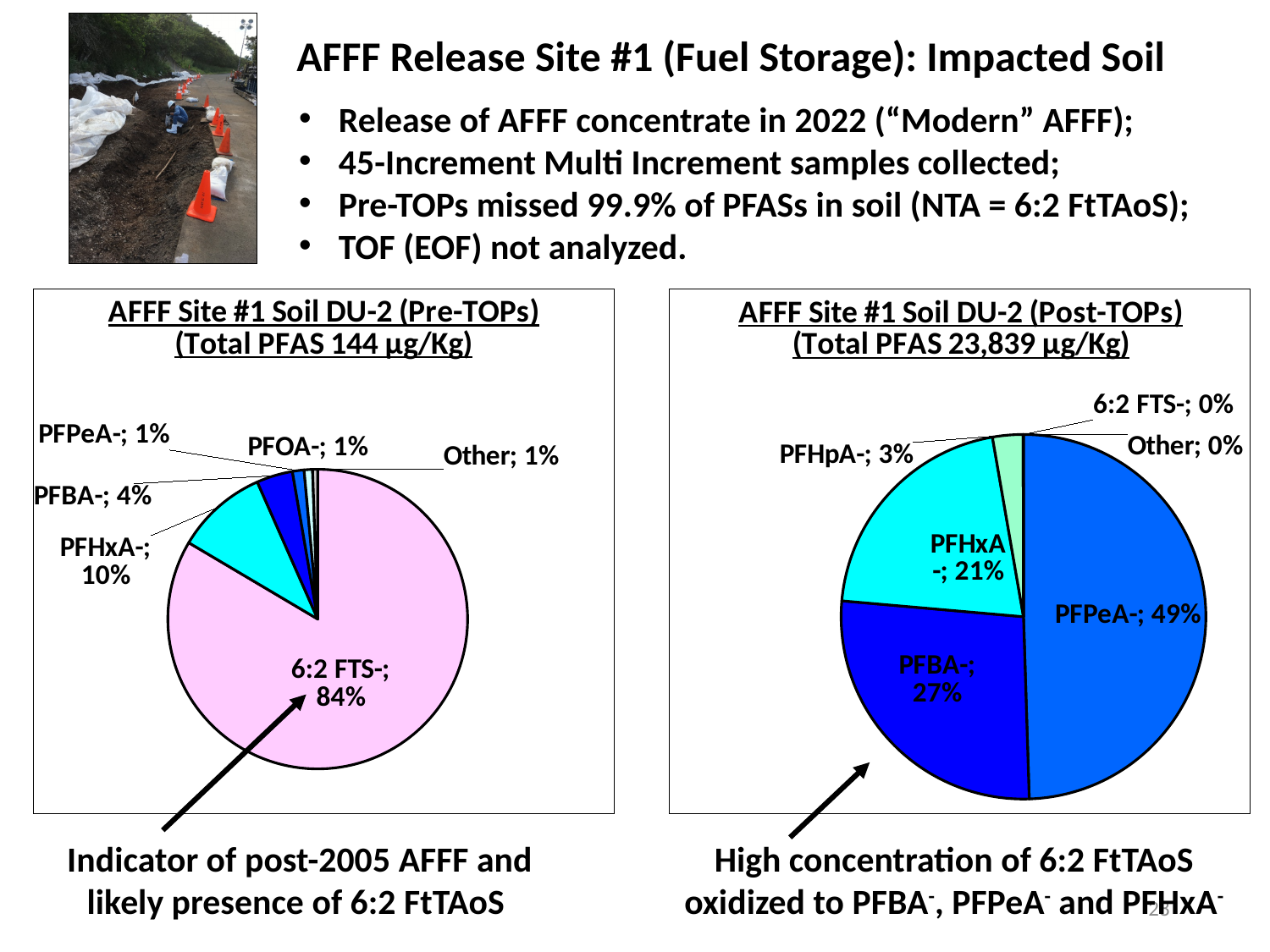
How many slices are labeled in the Post-TOPs pie chart (right)? 6 In the Pre-TOPs pie chart (left), which category has the largest slice? 6:2 FTS- What type of chart is used for AFFF Site #1 Soil DU-2 (Pre-TOPs)? Pie chart In the Pre-TOPs pie chart (left), what share does 6:2 FTS- have? 84% What total PFAS value is given in the title of the Post-TOPs chart (right)? 23,839 µg/Kg In the Post-TOPs pie chart (right), which category has the largest slice? PFPeA- In the Pre-TOPs pie chart (left), what share does PFHxA- have? 10% In the Pre-TOPs pie chart (left), which is larger, the PFBA- slice or the PFHxA- slice? PFHxA- In the Post-TOPs pie chart (right), what share does PFPeA- have? 49% In the Post-TOPs pie chart (right), what share does PFHpA- have? 3% In the Post-TOPs pie chart (right), what is the difference between the PFBA- share and the PFHxA- share? 6% What total PFAS value is given in the title of the Pre-TOPs chart (left)? 144 µg/Kg